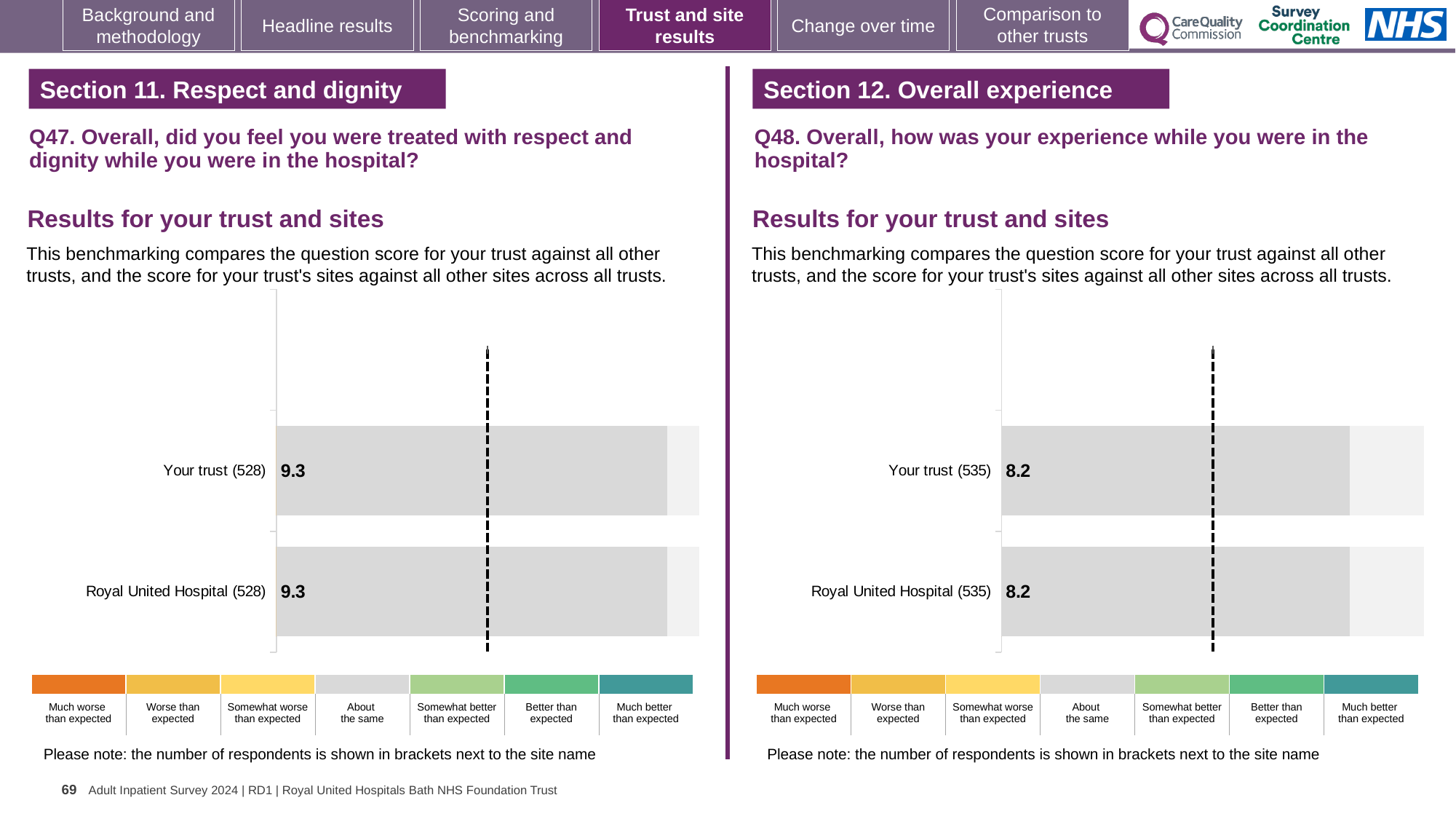
In the right chart (Q48), what is the difference between the score for Your trust and the score for Royal United Hospital? 0 In the right chart (Q48, overall experience), what is the score for Your trust? 8.2 How many bars are plotted in the right chart (Q48)? 2 What kind of chart is used in the left chart (Q47)? Bar chart In the left chart (Q47), how many respondents are shown in brackets next to Your trust? 528 In the left chart (Q47, respect and dignity), what is the score for Your trust? 9.3 In the left chart (Q47, respect and dignity), what is the score for Royal United Hospital? 9.3 In the left chart (Q47), what is the difference between the score for Your trust and the score for Royal United Hospital? 0 How many bars are plotted in the left chart (Q47)? 2 In the right chart (Q48, overall experience), what is the score for Royal United Hospital? 8.2 Is the score for Your trust in the left chart (Q47) larger or smaller than the score for Your trust in the right chart (Q48)? Larger In the right chart (Q48), how many respondents are shown in brackets next to Royal United Hospital? 535